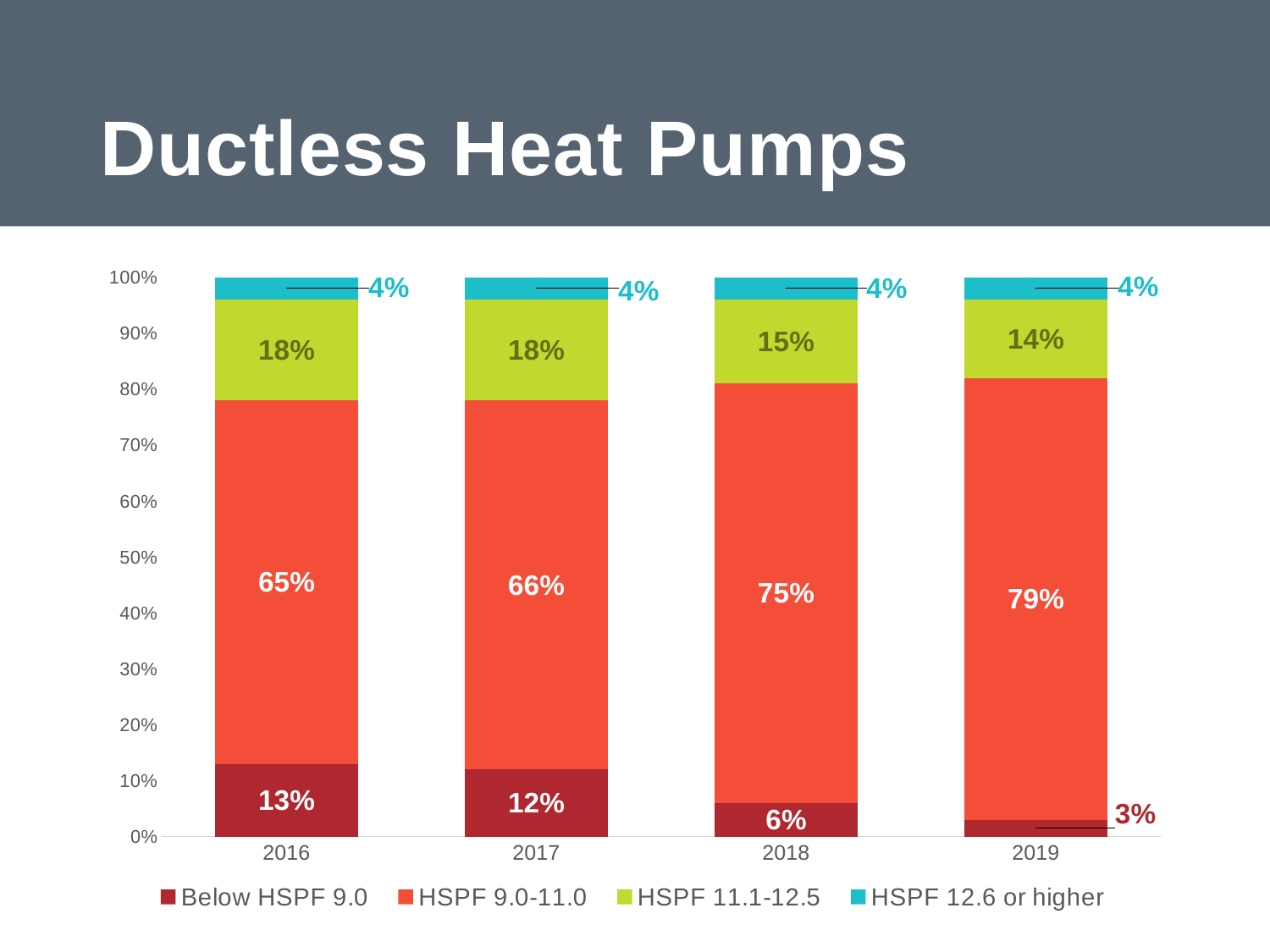
What share of ductless heat pumps in 2019 were HSPF 11.1-12.5? 14% What kind of chart is shown on the slide? Stacked bar chart Which is larger: the HSPF 11.1-12.5 share in 2016 or in 2018? 2016 Does the Below HSPF 9.0 share rise or fall from 2016 to 2019? Fall What share of ductless heat pumps in 2018 were HSPF 9.0-11.0? 75% In which year was the HSPF 9.0-11.0 share the highest? 2019 How many years are shown on the x axis? 4 How many series does the legend list? 4 In which year was the Below HSPF 9.0 share the lowest? 2019 By how many percentage points did the HSPF 9.0-11.0 share change from 2016 to 2019? 14 percentage points What share of ductless heat pumps in 2016 were Below HSPF 9.0? 13% What share of ductless heat pumps in 2017 were HSPF 12.6 or higher? 4%